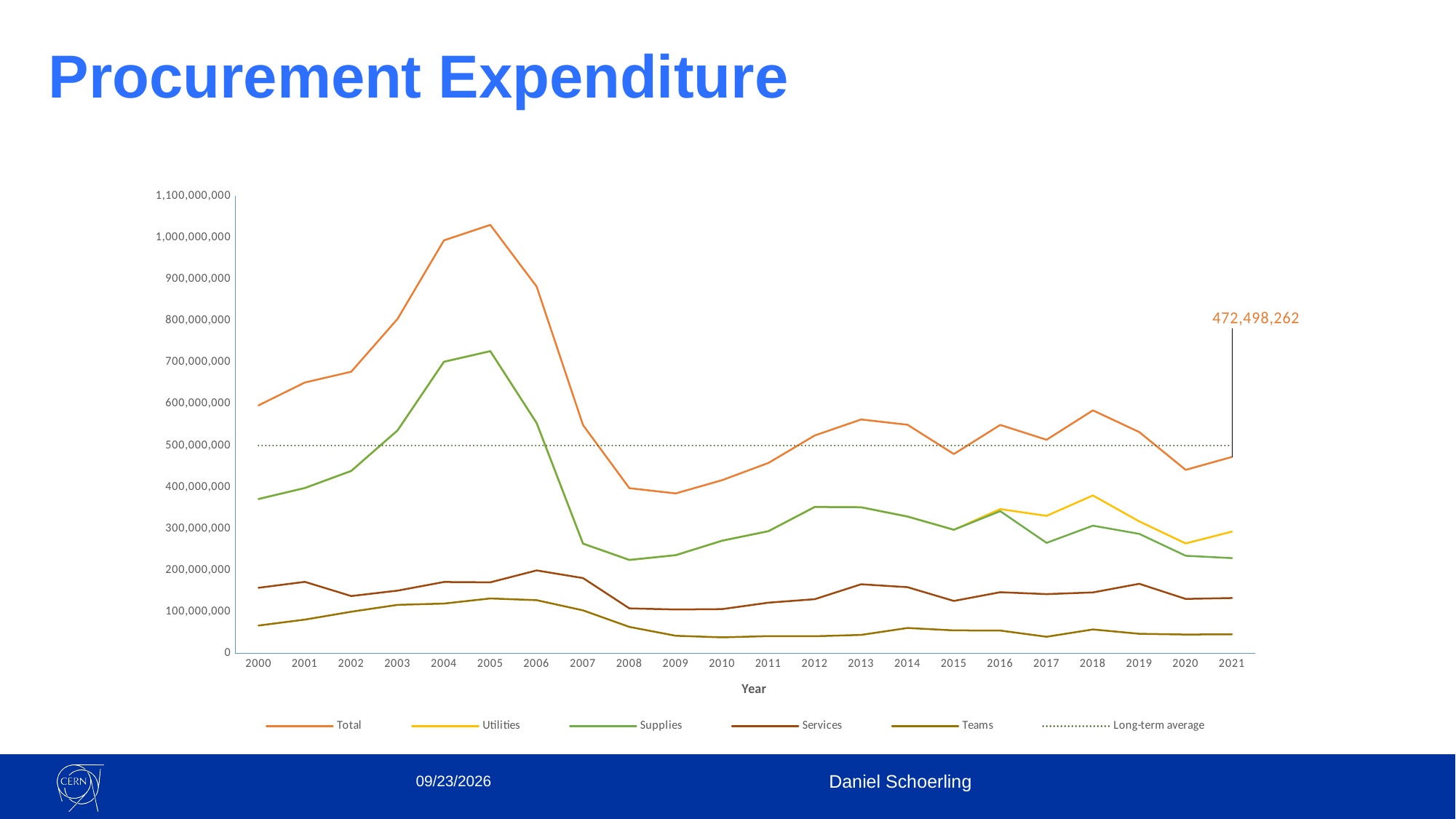
How many series does the legend list? 6 What is the Total procurement expenditure value labelled for 2021? 472,498,262 In which year does the Total series reach its highest value? 2005 Does the Total series rise or fall from 2005 to 2008? fall What kind of chart is shown on the slide? line chart Is the Teams value for 2021 greater or less than 100,000,000? less Which is larger in 2018, the Utilities value or the Supplies value? Utilities What is the title of the x axis? Year Is the Total value for 2005 greater or less than 1,000,000,000? greater Is the Total value for 2008 greater or less than 500,000,000? less In which year does the Supplies series reach its highest value? 2005 How many years are plotted along the x axis? 22